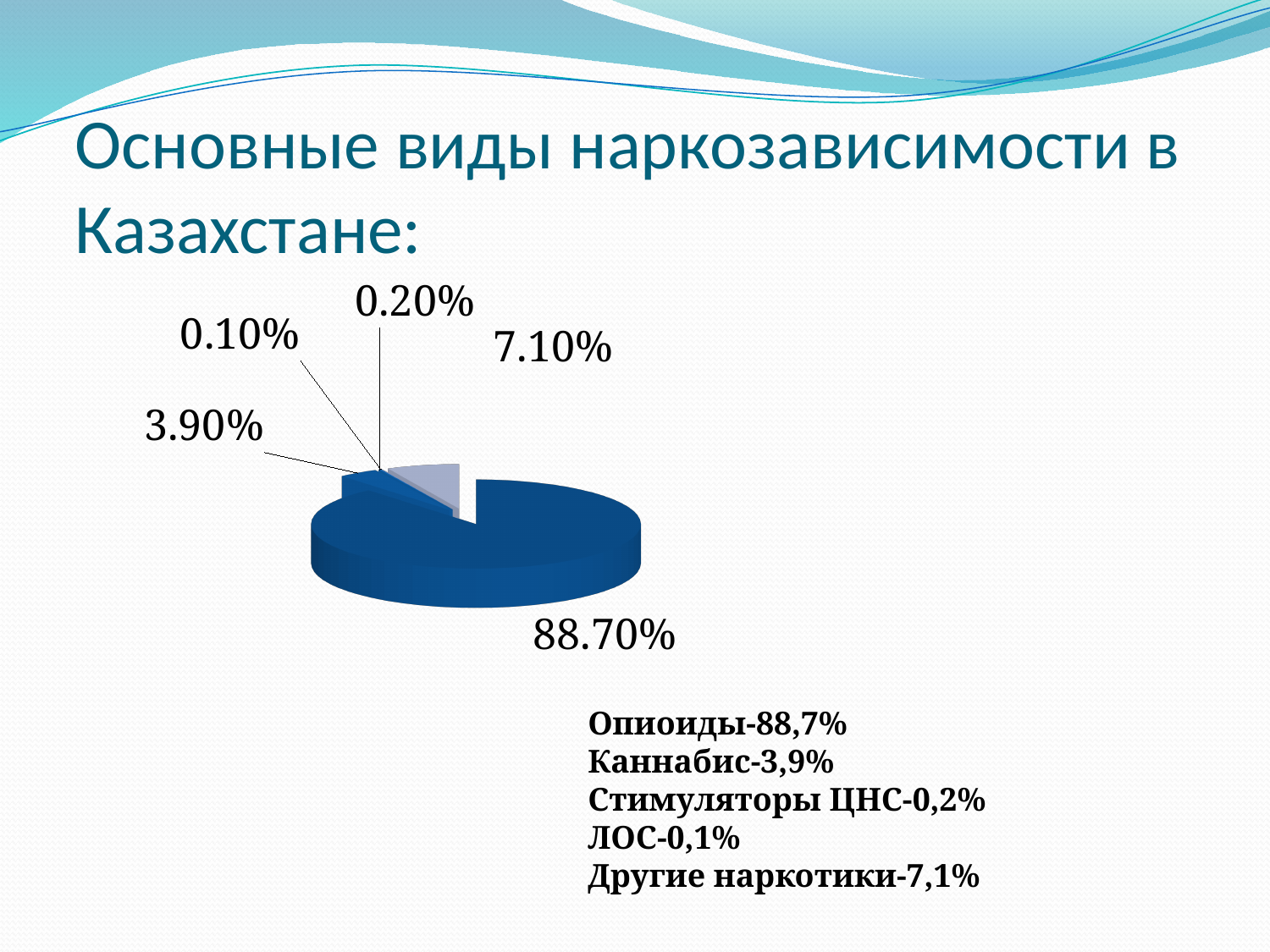
Which category has the largest share according to the slide? Опиоиды What kind of chart is shown on the slide? pie chart According to the slide, what share do Стимуляторы ЦНС have? 0,2% What is the difference between the 7.10% slice and the 3.90% slice on the pie chart? 3.20% What is the smallest value labelled on the pie chart? 0.10% Which is larger on the pie chart: the 7.10% slice or the 3.90% slice? 7.10% According to the slide, what share do Опиоиды have? 88,7% How many slices does the pie chart have? 5 What is the largest value labelled on the pie chart? 88.70% According to the slide, what share do Другие наркотики have? 7,1% According to the slide, what share does Каннабис have? 3,9% What is the title of the slide containing the pie chart? Основные виды наркозависимости в Казахстане: